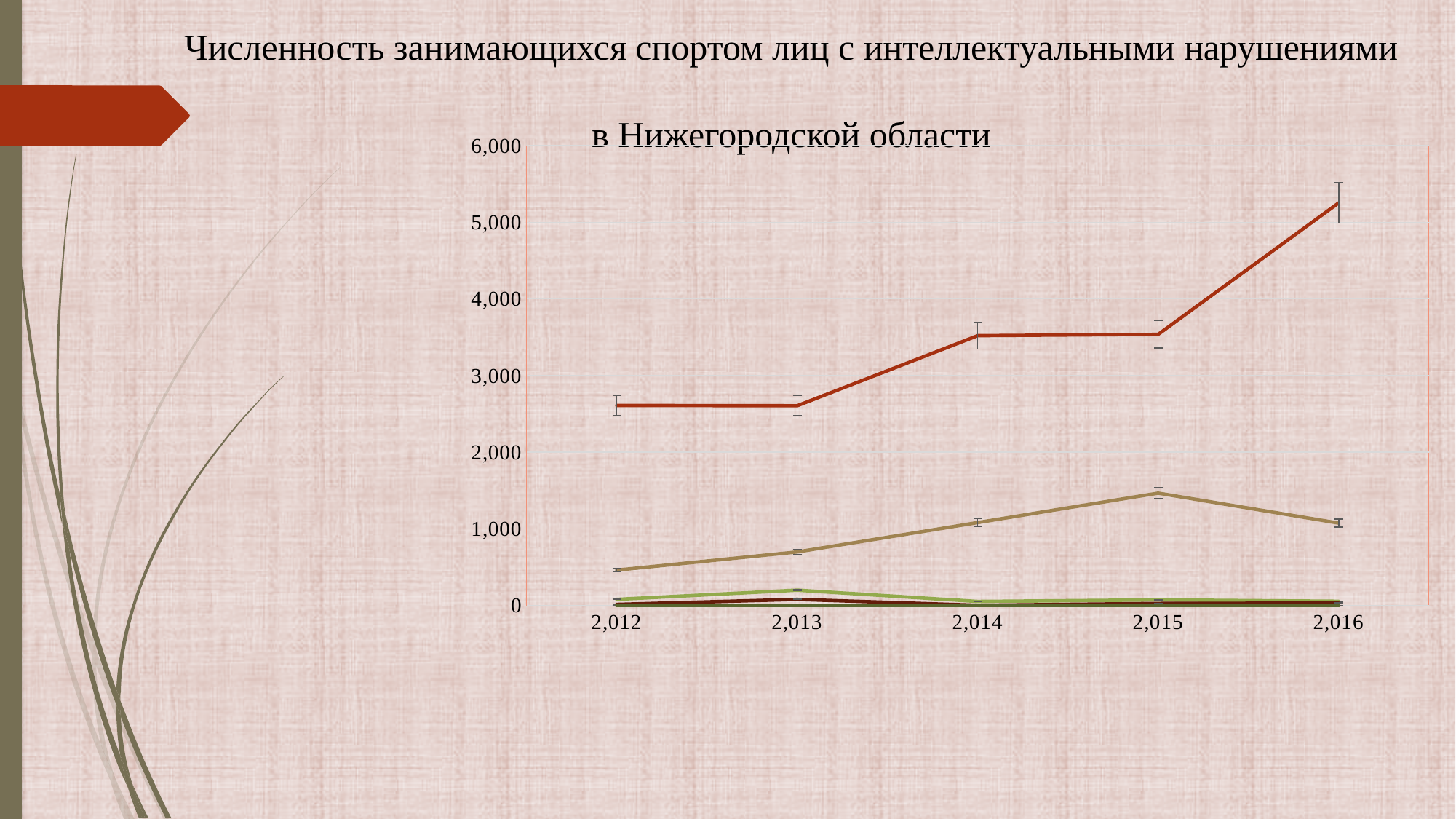
In which year is the tan (second) line at its lowest value? 2,012 Is the value of the red (top) line in 2,014 greater or less than 3,000? greater Is the value of the tan (second) line in 2,013 greater or less than 1,000? less Is the value of the red (top) line in 2,016 greater or less than 5,000? greater What is the highest tick value shown on the y axis of the chart? 6,000 In which year does the red (top) line reach its highest value? 2,016 What kind of chart is shown on the slide? line chart How many years are shown along the x axis of the chart? 5 Which line has the larger value in 2,016, the red line or the tan line? the red line In which year does the tan (second) line reach its highest value? 2,015 Does the red (top) line rise or fall overall from 2,012 to 2,016? rise